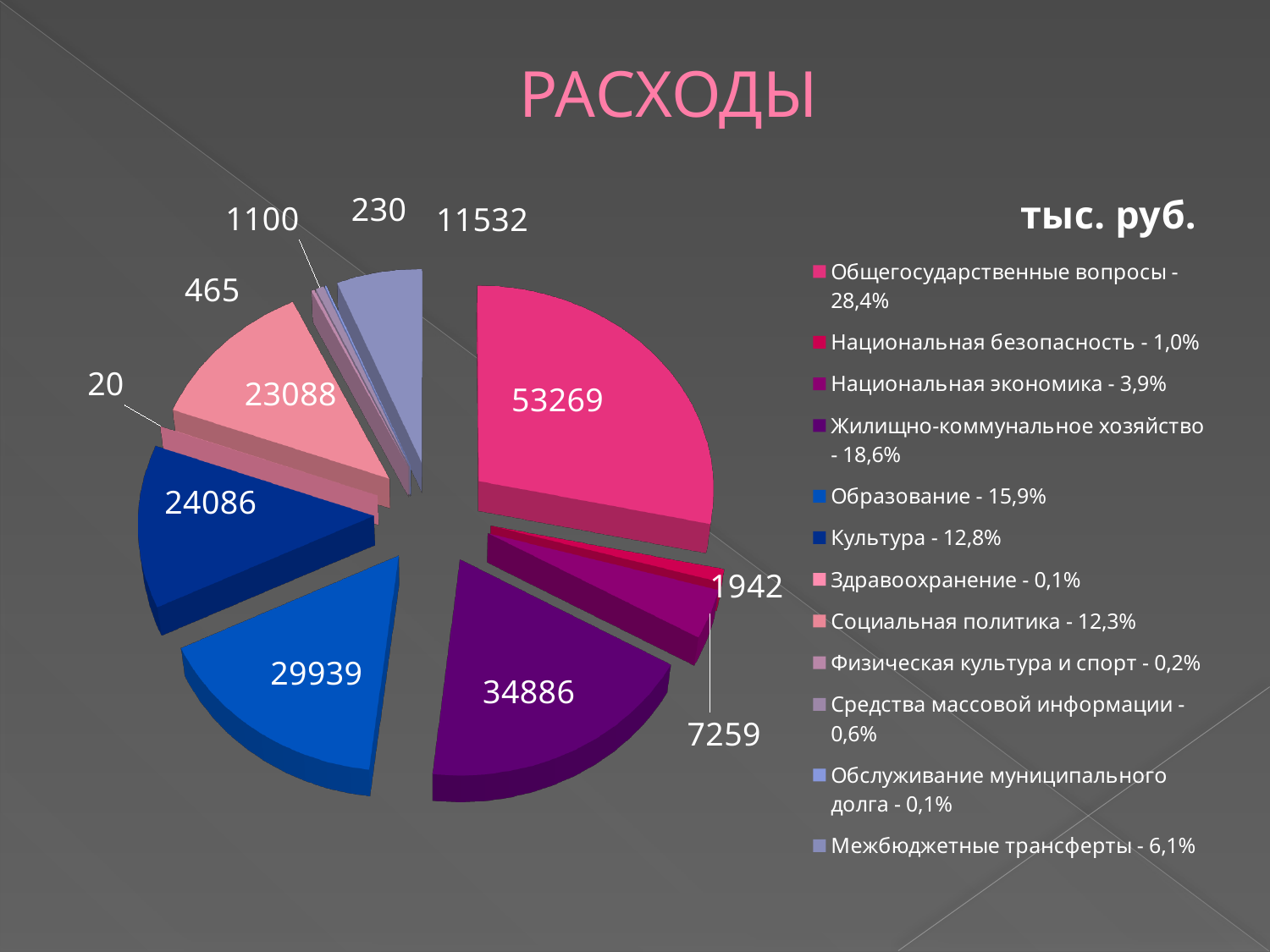
What unit is stated above the legend? тыс. руб. Which is larger, the value for Образование or the value for Культура? Образование Which category has the largest slice of the pie? Общегосударственные вопросы What is the value for Образование? 29939 What is the difference between the values for Общегосударственные вопросы and Жилищно-коммунальное хозяйство? 18383 What share of the pie does Культура represent, according to the legend? 12,8% Which category has the smallest value? Здравоохранение What is the value for Общегосударственные вопросы? 53269 How many categories does the pie chart have? 12 What is the value for Жилищно-коммунальное хозяйство? 34886 What is the value for Межбюджетные трансферты? 11532 What type of chart is shown on the slide? pie chart